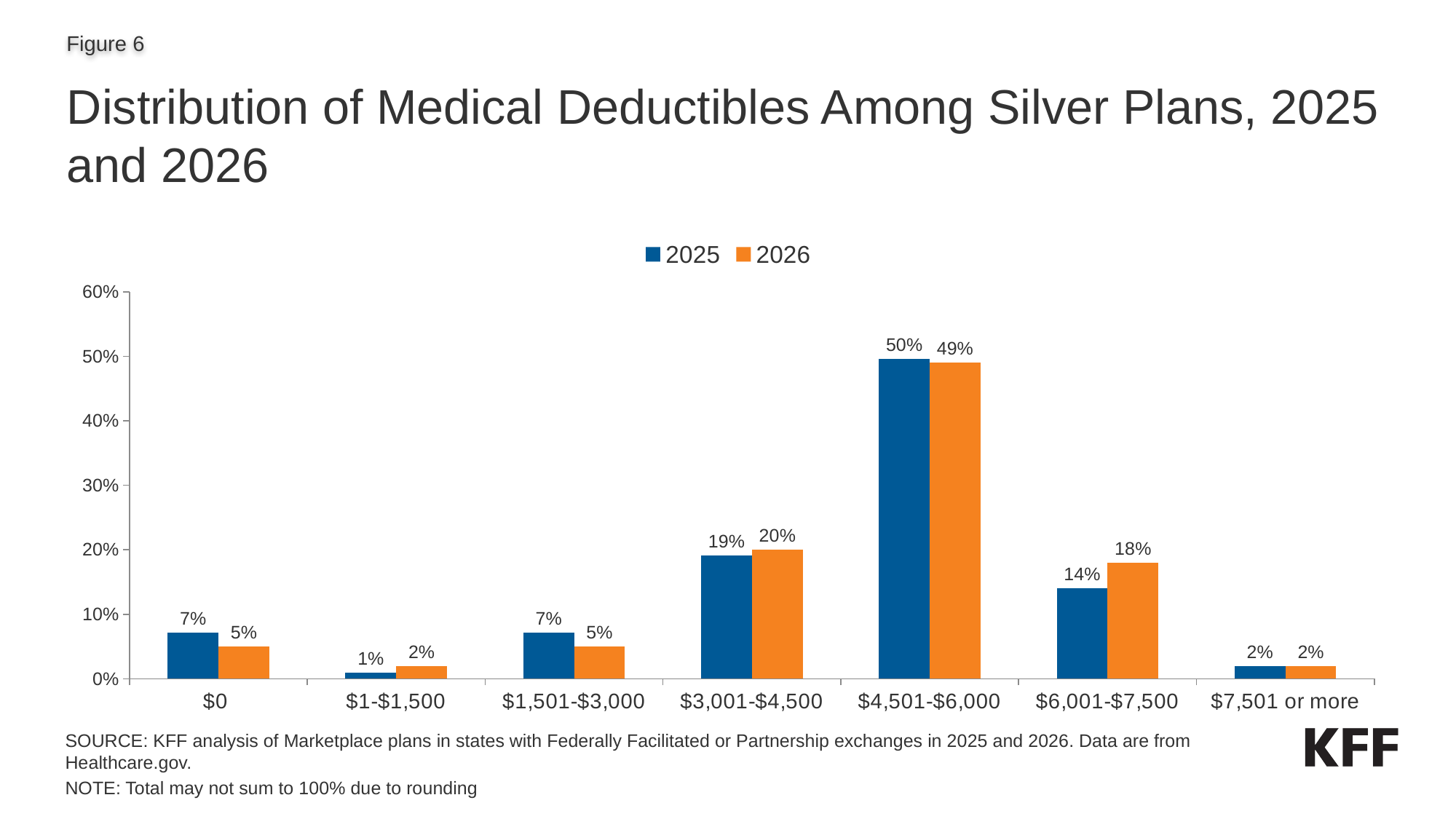
How many series does the legend list? 2 Which deductible range has the highest share of Silver plans in 2025? $4,501-$6,000 Which deductible range has the lowest share of Silver plans in 2025? $1-$1,500 How many deductible ranges are shown on the x axis? 7 For the $1,501-$3,000 range, which year has the larger share, 2025 or 2026? 2025 What is the difference between the 2025 and 2026 values for the $6,001-$7,500 range? 4 percentage points What kind of chart is shown on the slide? Bar chart What percentage of Silver plans had a $0 medical deductible in 2025? 7% Which colour represents 2026 in the chart? Orange What is the 2026 value for the $4,501-$6,000 deductible range? 49% What percentage of Silver plans had a medical deductible of $6,001-$7,500 in 2026? 18% Is the 2025 value for the $4,501-$6,000 range greater or less than 40%? greater